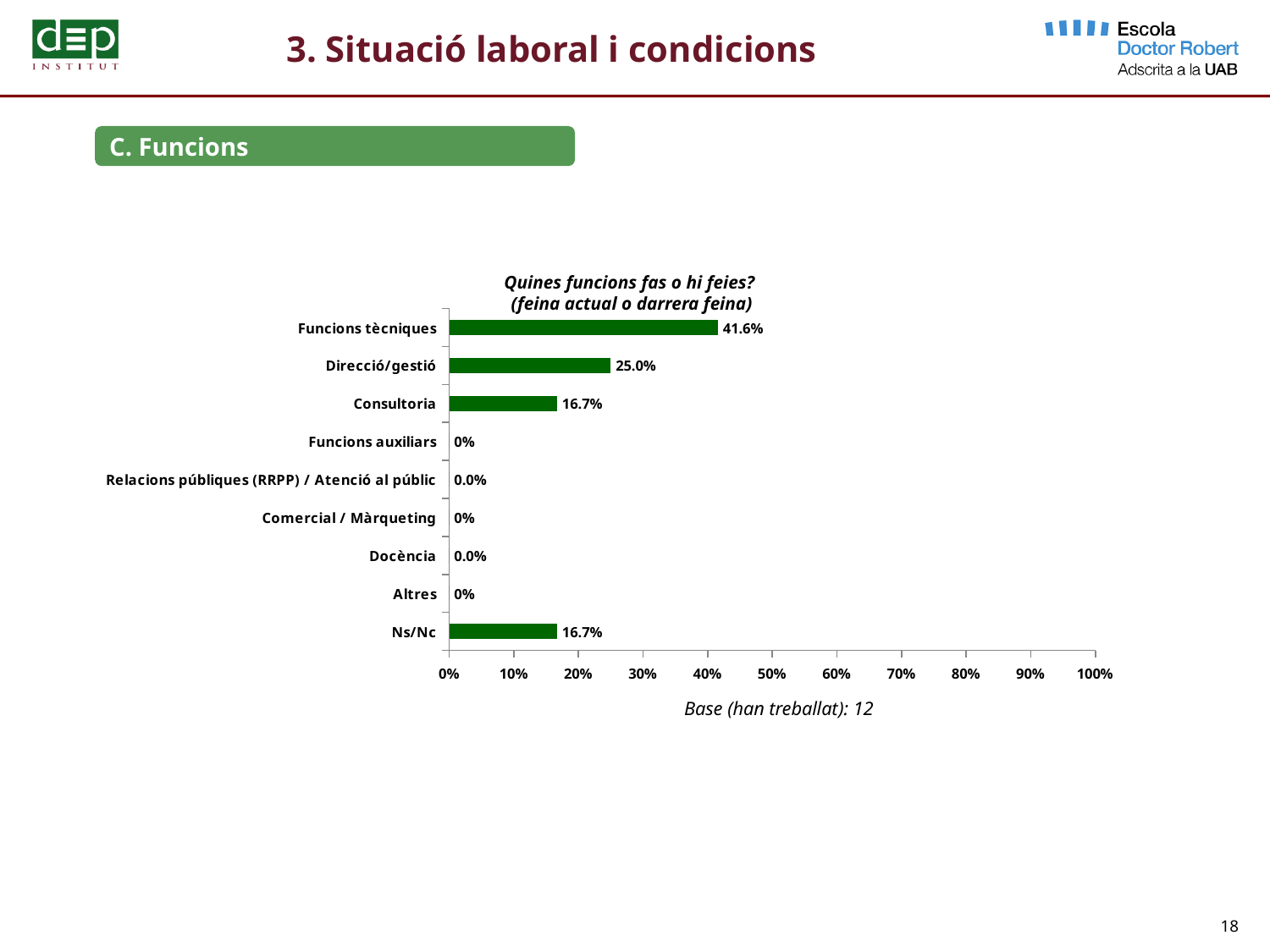
What is the difference between the values for Funcions tècniques and Direcció/gestió? 16.6% What is the value for Docència? 0.0% Which is larger, the value for Direcció/gestió or the value for Consultoria? Direcció/gestió What is the value for Funcions tècniques? 41.6% What is the value for Direcció/gestió? 25.0% What is the difference between the values for Direcció/gestió and Consultoria? 8.3% What is the value for Consultoria? 16.7% Is the value for Funcions tècniques greater or less than 50%? less What is the value for Ns/Nc? 16.7% What kind of chart is shown on the slide? bar chart Which category has the highest value? Funcions tècniques How many categories are shown on the chart? 9